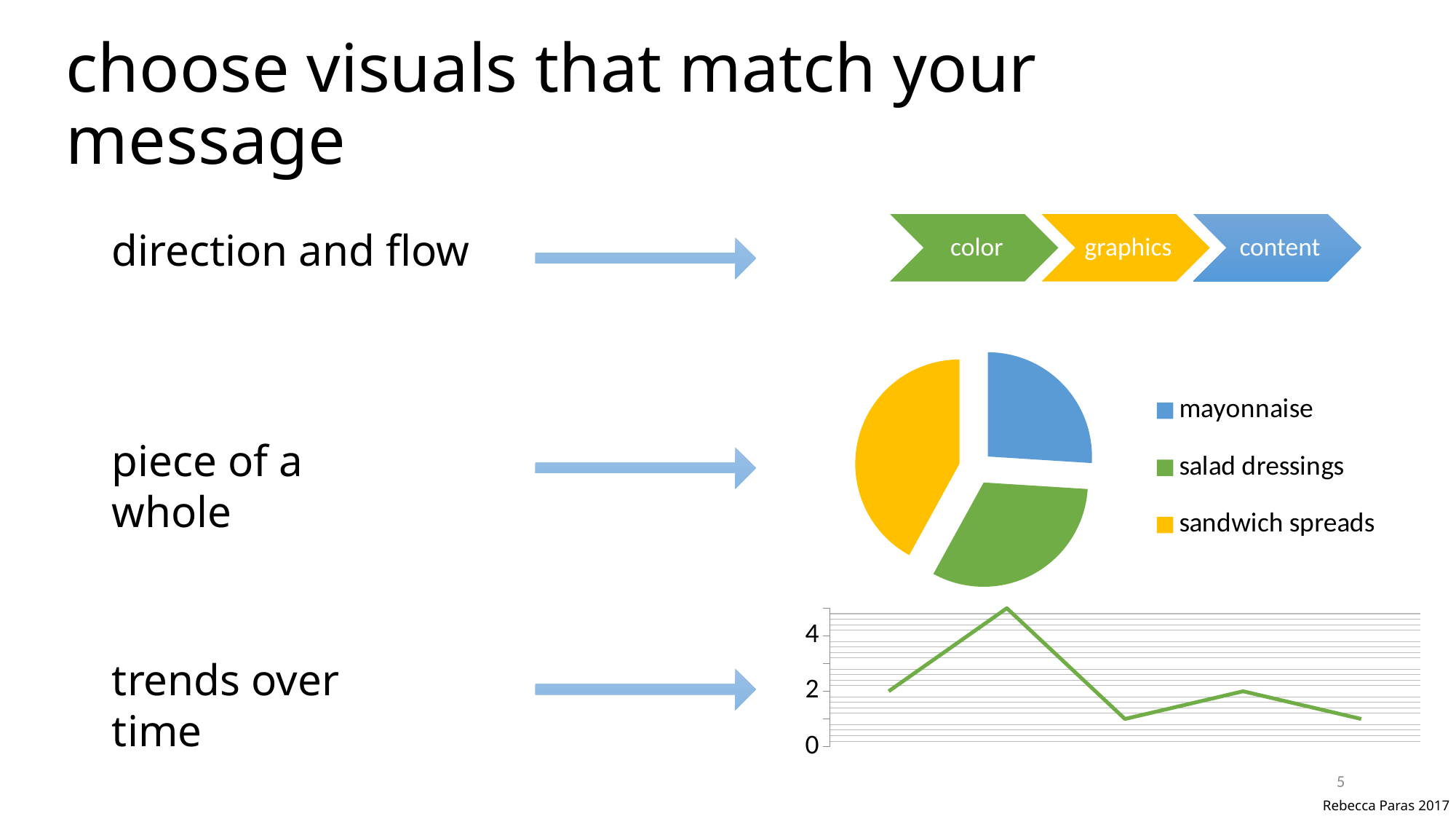
What kind of chart is the chart next to "trends over time"? line chart In the pie chart, which category has the smallest slice? mayonnaise In the line chart next to "trends over time", is the highest point greater or less than 4? greater In the pie chart, what colour is the sandwich spreads slice? yellow How many data points does the line chart next to "trends over time" plot? 5 In the pie chart, which slice is larger: salad dressings or mayonnaise? salad dressings In the line chart next to "trends over time", is the last point greater or less than 2? less What kind of chart is the chart next to "piece of a whole"? pie chart In the pie chart, which category has the largest slice? sandwich spreads In the line chart next to "trends over time", does the line rise or fall between the second and third points? fall How many entries does the legend of the pie chart list? 3 What is the highest labelled tick on the y axis of the line chart next to "trends over time"? 4